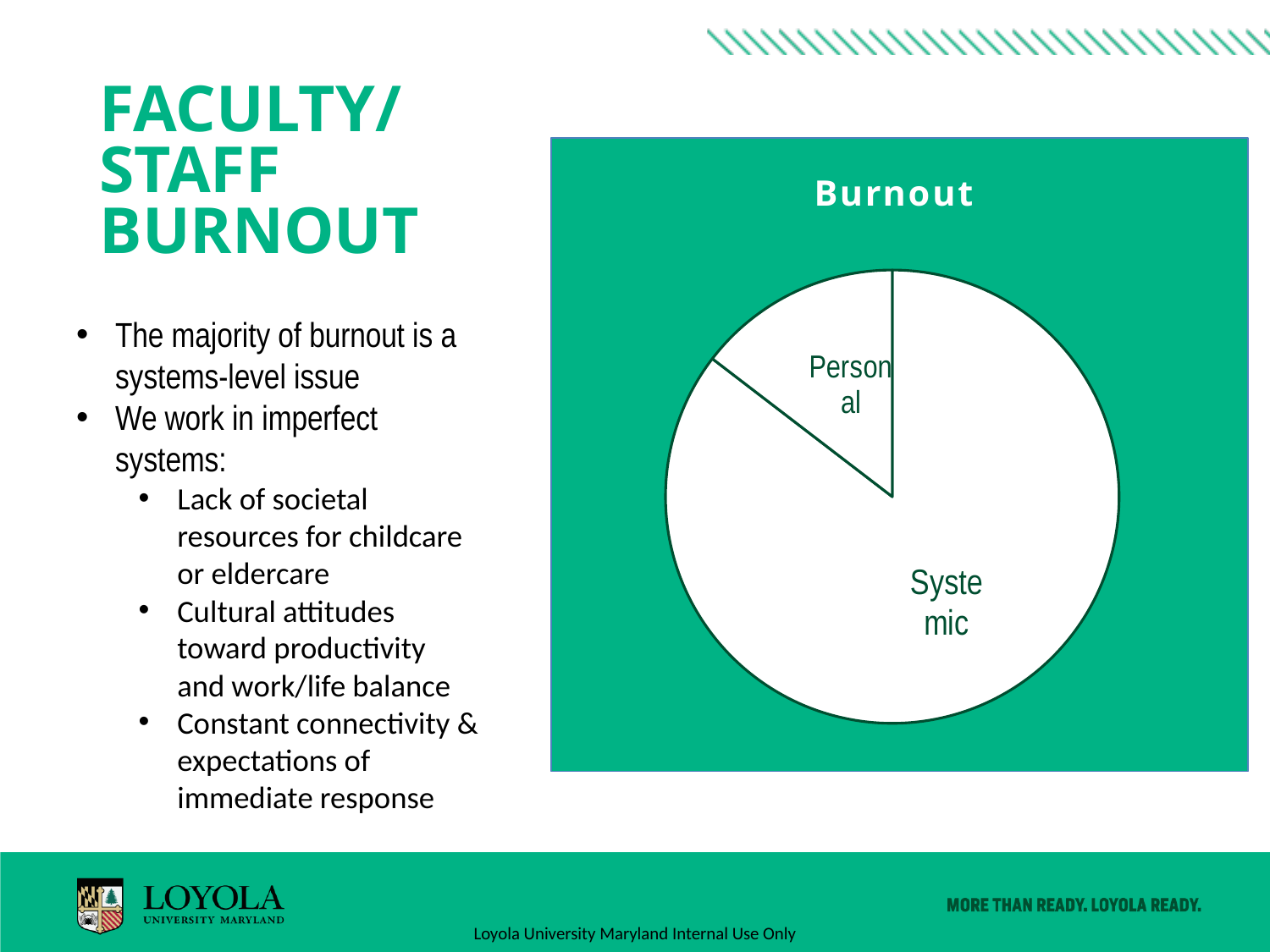
In the Burnout pie chart, which is larger: the Personal slice or the Systemic slice? Systemic What are the two categories shown in the Burnout pie chart? Personal and Systemic What is the title of the chart? Burnout Which slice of the Burnout pie chart is the largest? Systemic How many slices does the Burnout pie chart have? 2 What kind of chart is shown on the slide? pie chart Which slice of the Burnout pie chart is the smallest? Personal